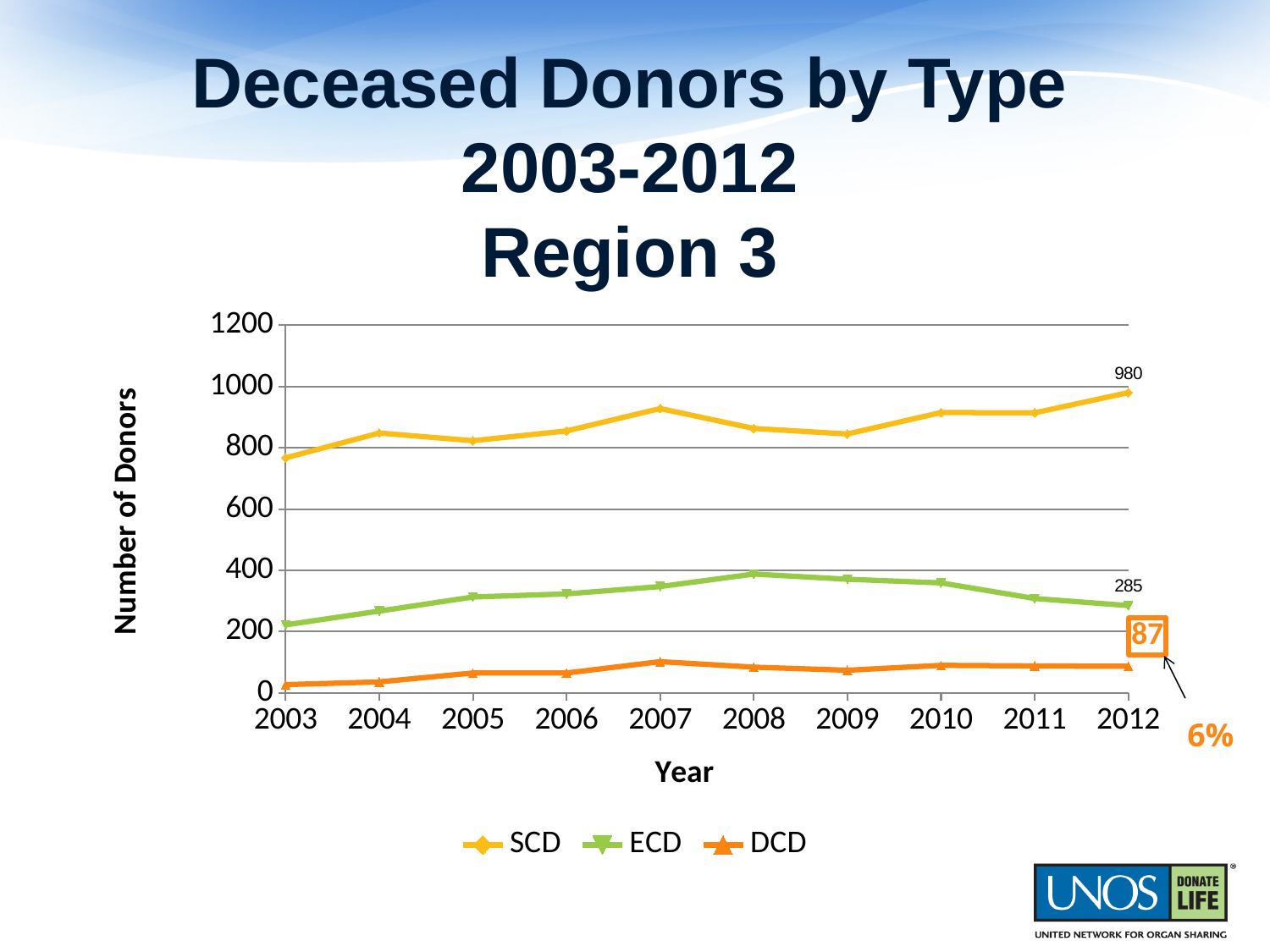
Is the value for SCD in 2003 greater or less than 800? less What is the difference between the SCD and ECD values in 2012? 695 Which series has the highest value in 2012? SCD In which year is the SCD series at its highest? 2012 Is the value for DCD in 2007 greater or less than 200? less How many series does the legend list? 3 What kind of chart is shown on the slide? line chart What is the value for SCD in 2012? 980 What is the value for DCD in 2012? 87 How many years are shown on the x axis? 10 Does the ECD series rise or fall from 2008 to 2012? fall What is the value for ECD in 2012? 285